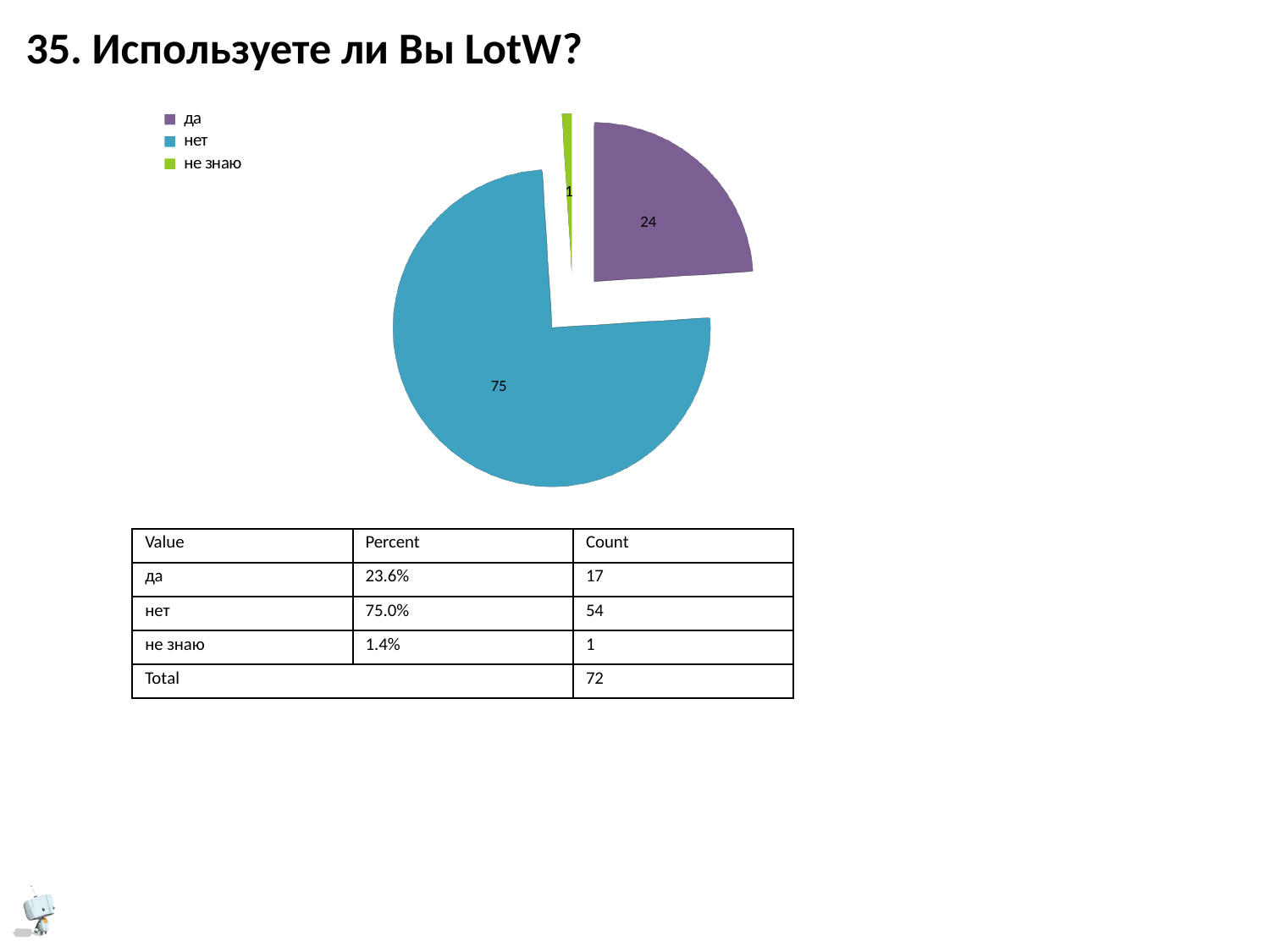
What is the data label shown on the pie slice for "да"? 24 Which category has the smallest slice in the pie chart? не знаю How many slices does the pie chart have? 3 What is the data label shown on the pie slice for "не знаю"? 1 What is the title of the slide containing the pie chart? 35. Используете ли Вы LotW? What is the difference between the data labels of the "нет" and "да" slices? 51 Which slice is larger in the pie chart, "да" or "нет"? нет What colour is the "нет" slice in the pie chart? blue How many entries does the legend of the pie chart list? 3 What is the data label shown on the pie slice for "нет"? 75 What type of chart is shown on the slide? pie chart Which category has the largest slice in the pie chart? нет